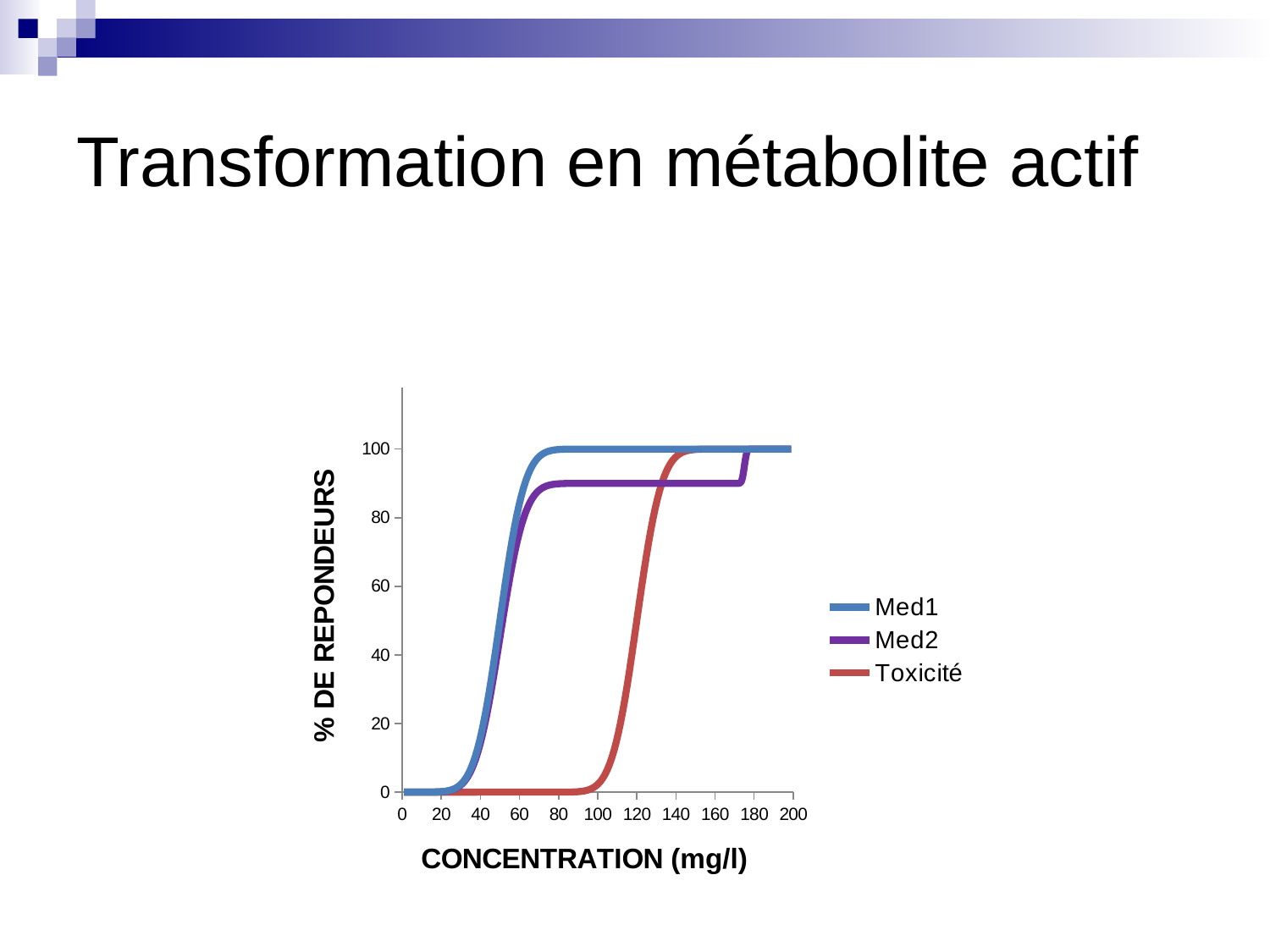
How many series does the legend list? 3 Does the Med1 curve rise or fall as concentration increases? rise Is the value for Toxicité at a concentration of 80 mg/l greater or less than 20? less What are the three series named in the legend? Med1, Med2, Toxicité At a concentration of 100 mg/l, which series has the higher value, Med1 or Toxicité? Med1 At a concentration of 120 mg/l, which series has the higher value, Med1 or Med2? Med1 Is the value for Med2 at a concentration of 120 mg/l greater or less than 80? greater Is the value for Med1 at a concentration of 20 mg/l greater or less than 20? less Which series starts rising at the highest concentration? Toxicité What is the title of the x axis? CONCENTRATION (mg/l) What kind of chart is shown on the slide? line chart